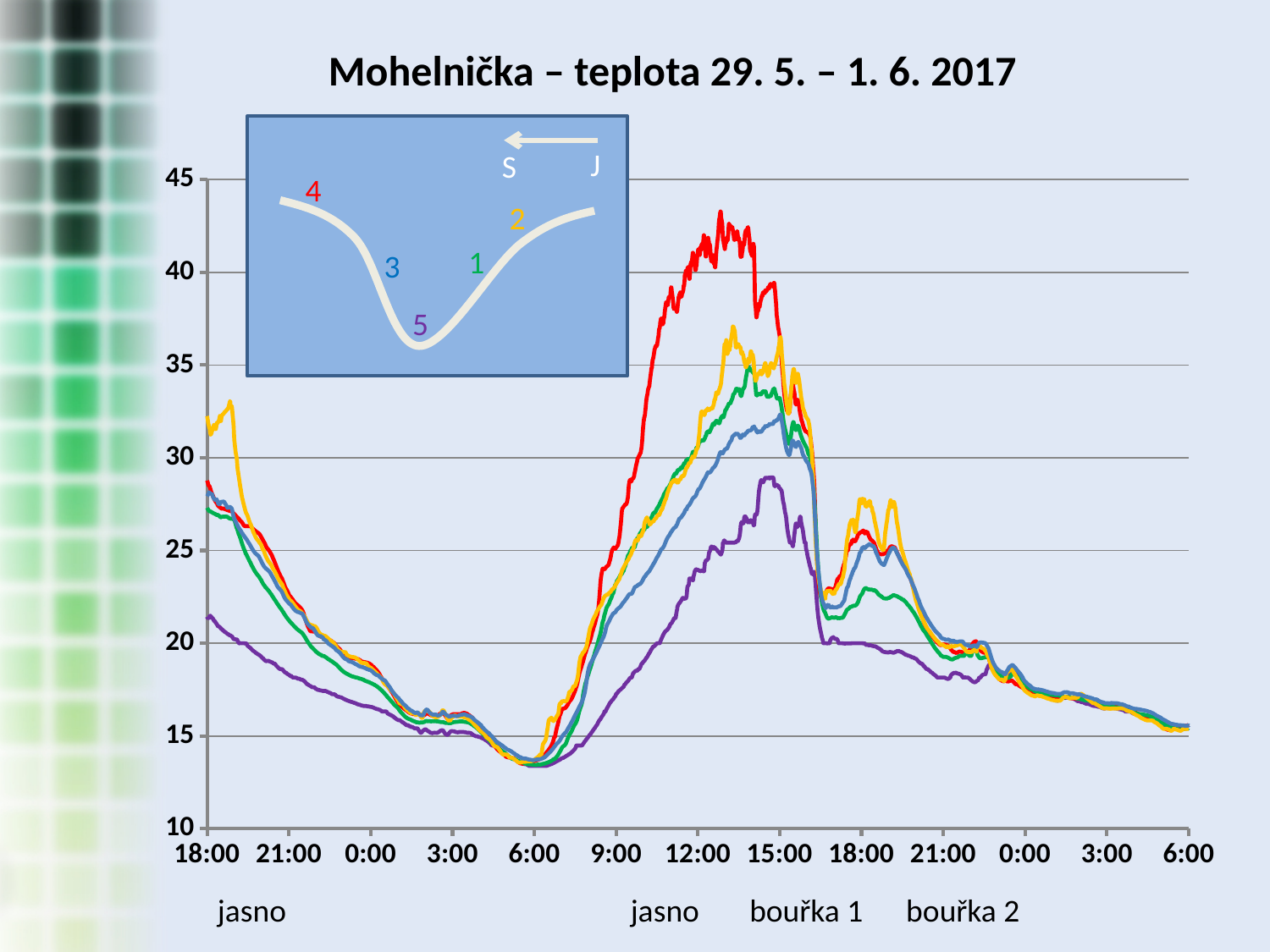
Is the value of the yellow line at its early spike around 19:00 on the first evening greater or less than 30? greater How many coloured lines (series) are plotted on the chart? 5 Which labels are written below the x axis to describe the weather conditions? jasno, jasno, bouřka 1, bouřka 2 Is the peak value of the purple line around 14:30 greater or less than 30? less What kind of chart is shown on the slide? line chart Which coloured line reaches the highest peak on the chart? red Is the peak value of the red line around 13:00 greater or less than 40? greater What is the title of the chart? Mohelnička – teplota 29. 5. – 1. 6. 2017 Do the values rise or fall between 18:00 and 6:00 on the first night? fall Do the values rise or fall between 6:00 and 12:00 on the second day? rise Which coloured line has the lowest daytime peak around 15:00? purple